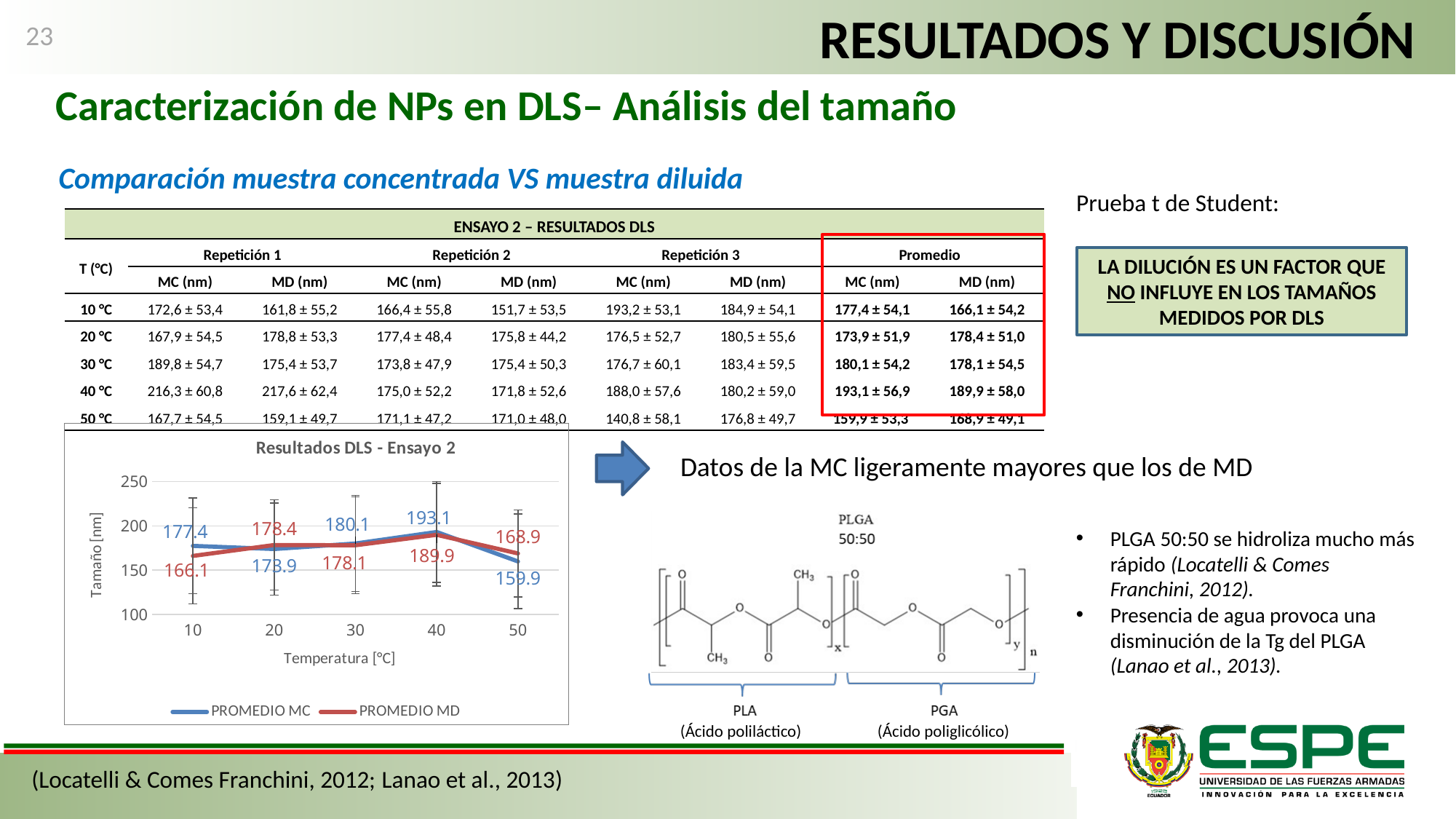
How many temperature points are plotted on the x axis of the chart? 5 What is the label of the y axis in the chart? Tamaño [nm] How many series does the chart legend list? 2 At which temperature does PROMEDIO MD have its lowest value? 10 What is the value of PROMEDIO MD at 10 °C in the chart 'Resultados DLS - Ensayo 2'? 166.1 Is the value of PROMEDIO MC at 40 °C greater or less than 150? greater Which series has the larger value at 50 °C, PROMEDIO MC or PROMEDIO MD? PROMEDIO MD At which temperature does PROMEDIO MC reach its highest value? 40 What is the value of PROMEDIO MC at 50 °C in the chart? 159.9 What type of chart is 'Resultados DLS - Ensayo 2'? line chart What is the difference between PROMEDIO MC and PROMEDIO MD at 10 °C? 11.3 What is the value of PROMEDIO MC at 40 °C in the chart 'Resultados DLS - Ensayo 2'? 193.1